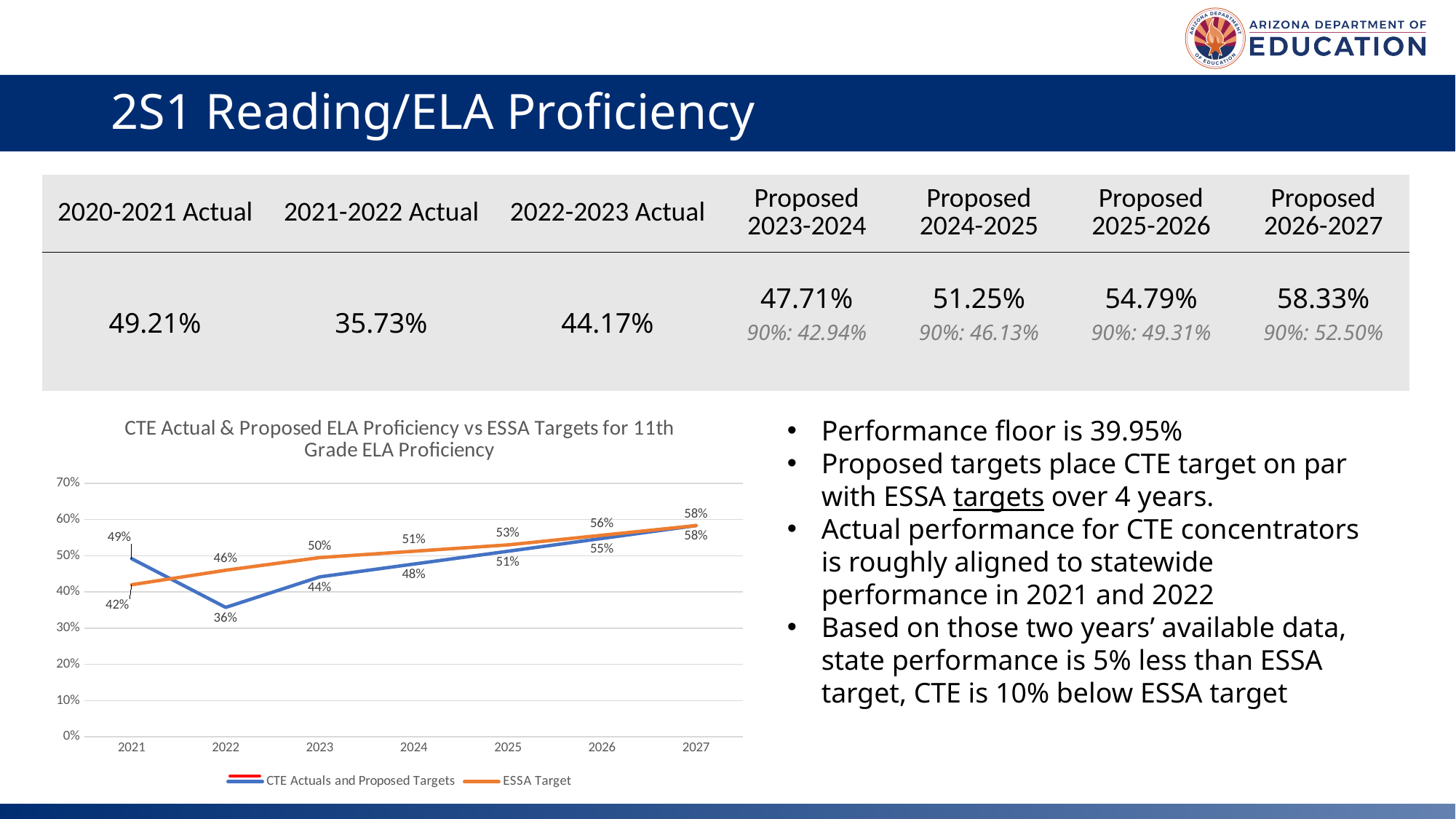
What is the CTE Actuals and Proposed Targets value for 2025? 51% In which year is the CTE Actuals and Proposed Targets value lowest? 2022 What is the ESSA Target value for 2021? 42% In which year is the ESSA Target value highest? 2027 What type of chart is shown on the slide? Line chart What is the title of the chart? CTE Actual & Proposed ELA Proficiency vs ESSA Targets for 11th Grade ELA Proficiency In 2021, which is larger: the CTE Actuals and Proposed Targets value or the ESSA Target value? CTE Actuals and Proposed Targets Does the ESSA Target line rise or fall from 2021 to 2027? Rise What is the difference between the ESSA Target and the CTE value in 2022? 10% How many series does the chart legend list? 2 What is the CTE Actuals and Proposed Targets value for 2022? 36% How many years are plotted along the x axis of the chart? 7